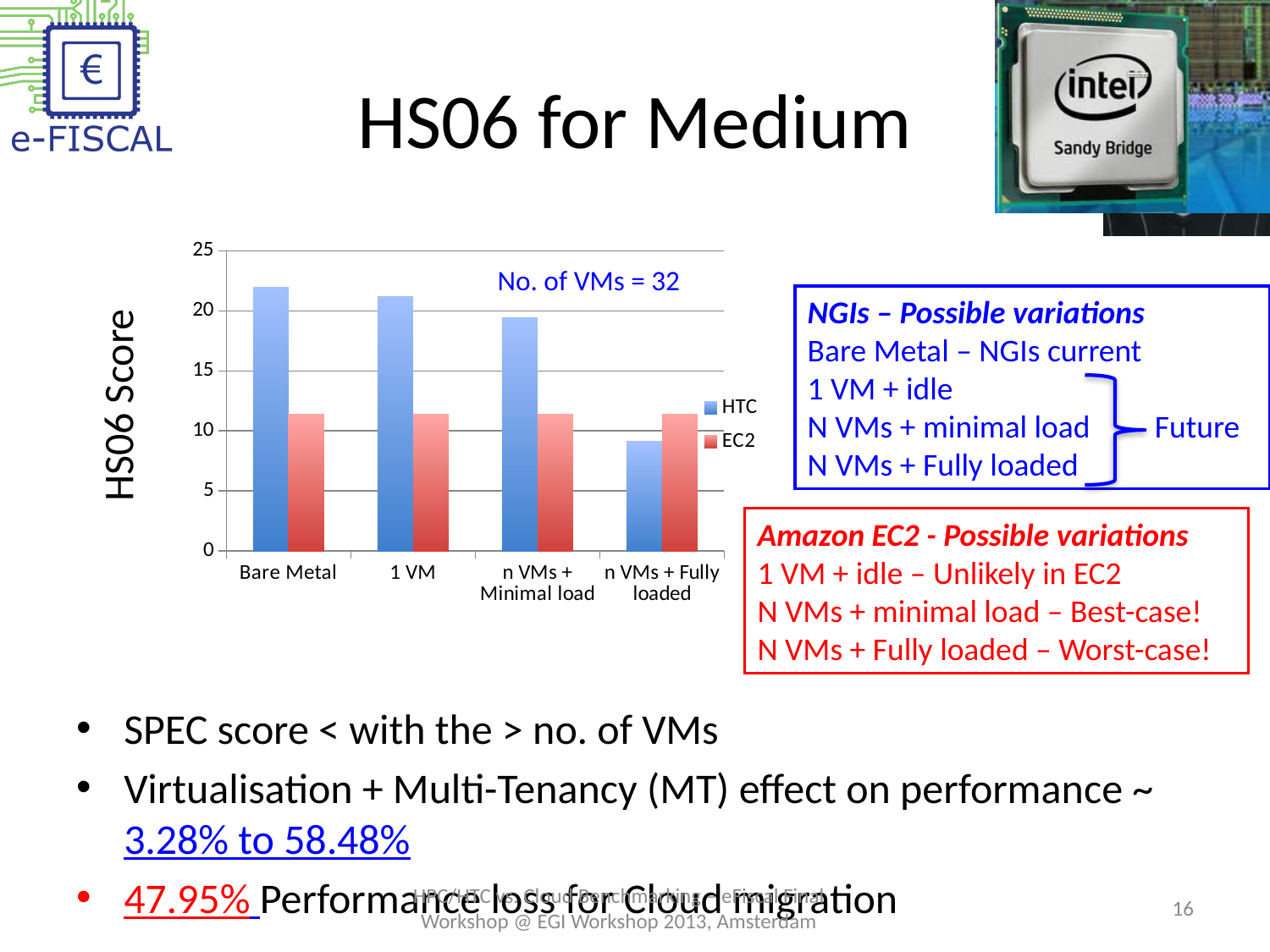
For n VMs + Fully loaded, which series has the larger value, HTC or EC2? EC2 Which category has the lowest HTC value? n VMs + Fully loaded Is the HTC value for n VMs + Fully loaded greater or less than 10? less Which category has the highest HTC value? Bare Metal Is the EC2 value for 1 VM greater or less than 10? greater What kind of chart is shown on the slide? bar chart What is the label of the chart's vertical axis? HS06 Score How many series does the chart legend list? 2 How many categories are shown on the x axis of the chart? 4 Is the HTC value for Bare Metal greater or less than 20? greater For Bare Metal, which series has the larger value, HTC or EC2? HTC Do the HTC values rise or fall moving from Bare Metal to n VMs + Fully loaded along the x axis? fall